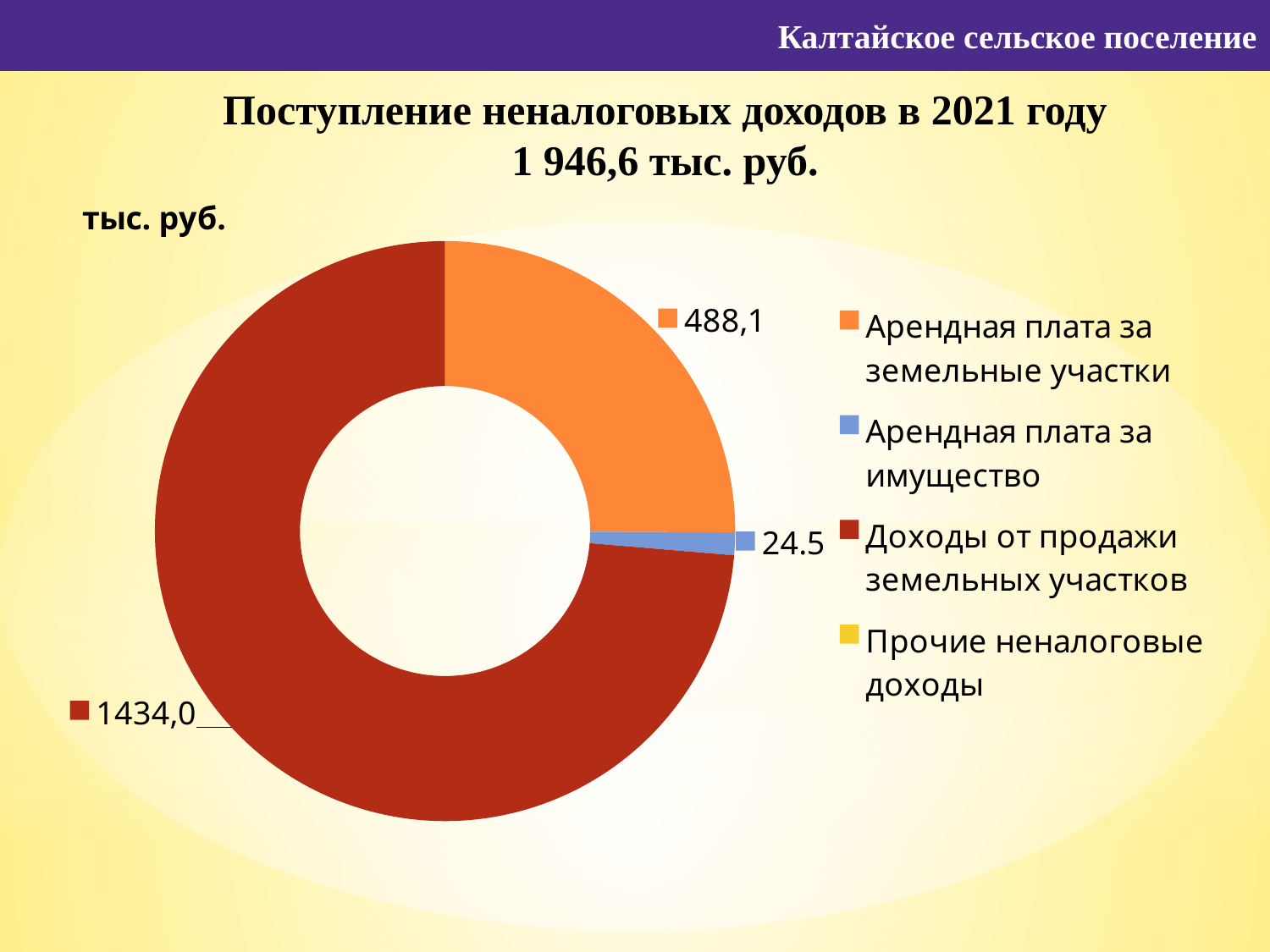
What colour represents Доходы от продажи земельных участков? Dark red Which labelled category has the smallest value? Арендная плата за имущество How many entries does the legend list? 4 What unit is indicated for the chart values? тыс. руб. What is the total of non-tax revenue shown in the chart title? 1 946,6 тыс. руб. Which category has the largest value? Доходы от продажи земельных участков What is the value for Арендная плата за имущество? 24.5 What is the value for Доходы от продажи земельных участков? 1434,0 What is the value for Арендная плата за земельные участки? 488,1 Which is larger: Арендная плата за земельные участки or Арендная плата за имущество? Арендная плата за земельные участки What is the difference between Доходы от продажи земельных участков and Арендная плата за земельные участки? 945,9 What type of chart is shown on the slide? Doughnut (pie) chart